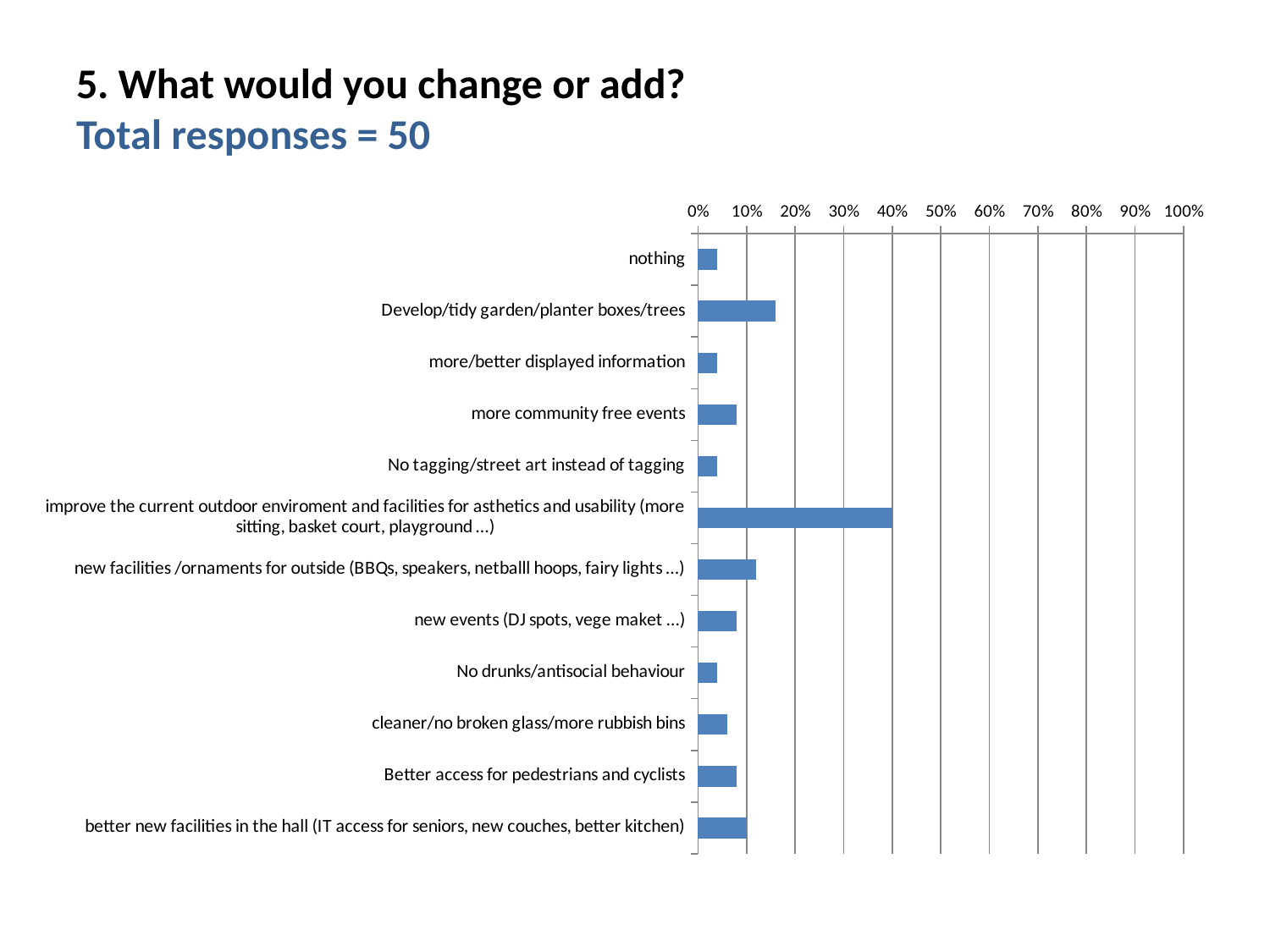
Is the value for "nothing" greater or less than 10%? less Is the value for "Develop/tidy garden/planter boxes/trees" greater or less than 10%? greater What is the title of the slide containing the chart? 5. What would you change or add? Is the value for "Develop/tidy garden/planter boxes/trees" greater or less than 20%? less Which category has the highest value in the chart? improve the current outdoor enviroment and facilities for asthetics and usability (more sitting, basket court, playground ...) What kind of chart is shown on the slide? bar chart According to the slide, what is the total number of responses? 50 Which is larger: the value for "Develop/tidy garden/planter boxes/trees" or the value for "new facilities /ornaments for outside (BBQs, speakers, netballl hoops, fairy lights ...)"? Develop/tidy garden/planter boxes/trees How many categories are plotted in the chart? 12 What is the value for "improve the current outdoor enviroment and facilities for asthetics and usability (more sitting, basket court, playground ...)"? 40%